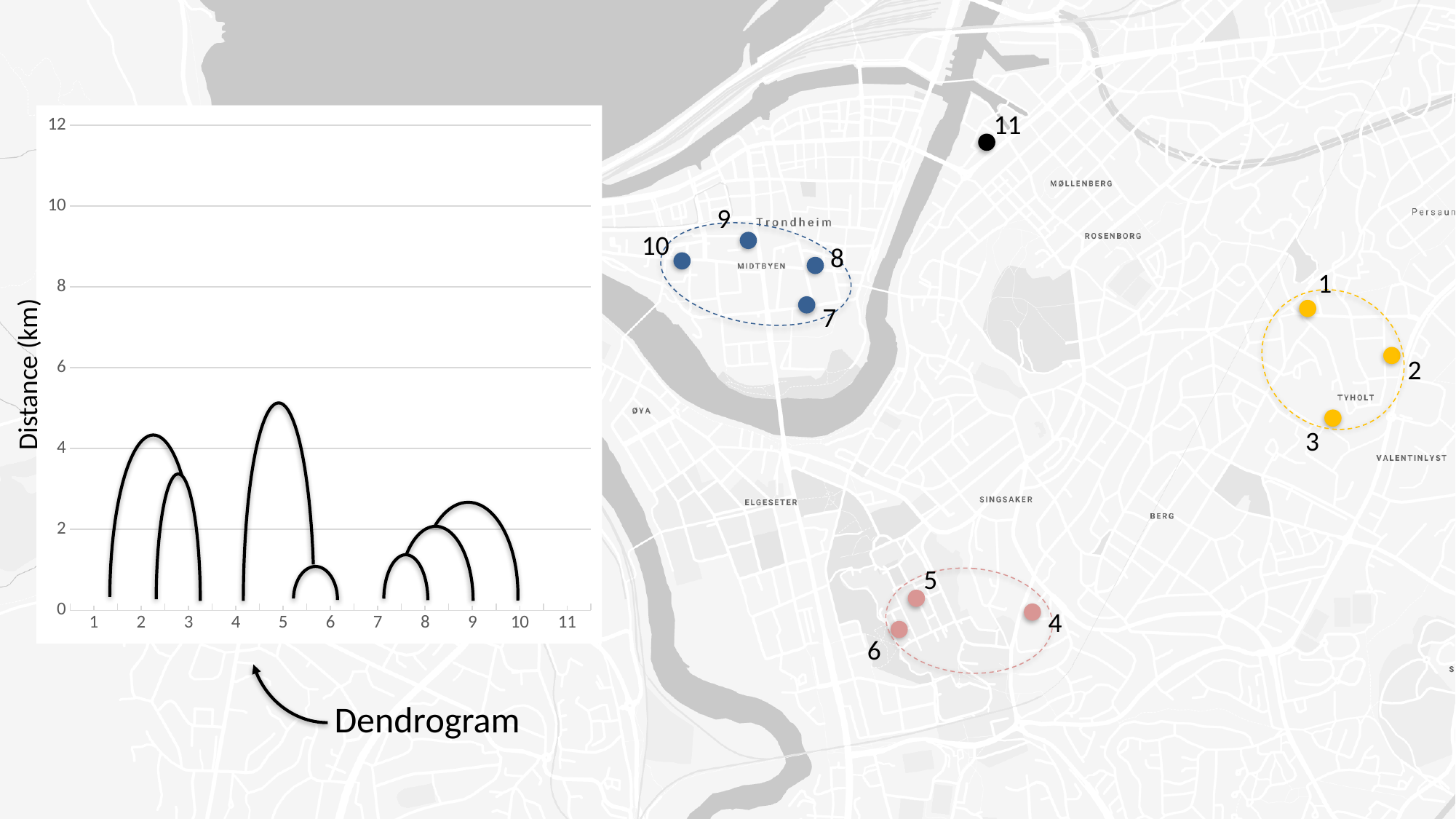
In the dendrogram, is the height at which points 2 and 3 are joined greater or less than 4? less What is the highest value shown on the y-axis of the dendrogram? 12 In the dendrogram, is the height at which points 7 and 8 are joined greater or less than 2? less In the dendrogram, is the height of the arc joining point 4 to the 5–6 cluster greater or less than 6? less What kind of chart is shown on the left of the slide? dendrogram In the dendrogram, which arc reaches the greatest distance: the one joining point 1 to the 2–3 cluster, or the one joining point 4 to the 5–6 cluster? the one joining point 4 to the 5–6 cluster What is the label on the y-axis of the dendrogram chart? Distance (km) How many labelled points are there along the x-axis of the dendrogram? 11 Which x-axis point in the dendrogram is not joined by any arc? 11